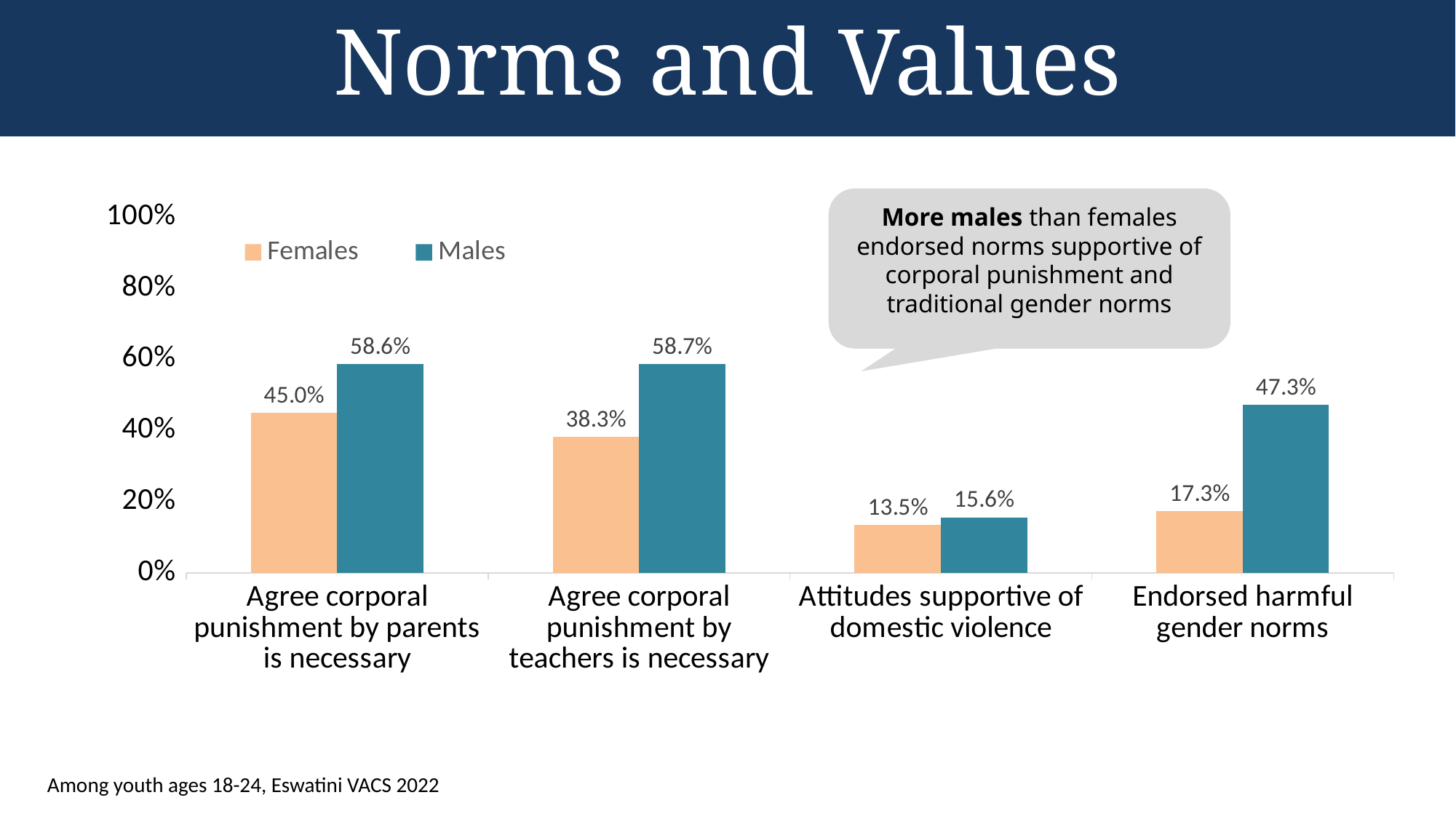
What kind of chart is shown on the slide? Bar chart Which category has the highest value for males? Agree corporal punishment by teachers is necessary Which category has the lowest value for females? Attitudes supportive of domestic violence What is the difference between the female values for corporal punishment by parents and corporal punishment by teachers? 6.7% Which is larger: the female value for 'Agree corporal punishment by parents is necessary' or the male value for 'Endorsed harmful gender norms'? Male value for 'Endorsed harmful gender norms' What percentage of females agree corporal punishment by parents is necessary? 45.0% What percentage of females had attitudes supportive of domestic violence? 13.5% What is the value for males for 'Endorsed harmful gender norms'? 47.3% Is the male value for 'Agree corporal punishment by parents is necessary' greater or less than 60%? less How many series does the legend list? 2 What is the difference between males and females for 'Endorsed harmful gender norms'? 30.0% How many categories are shown on the x axis? 4